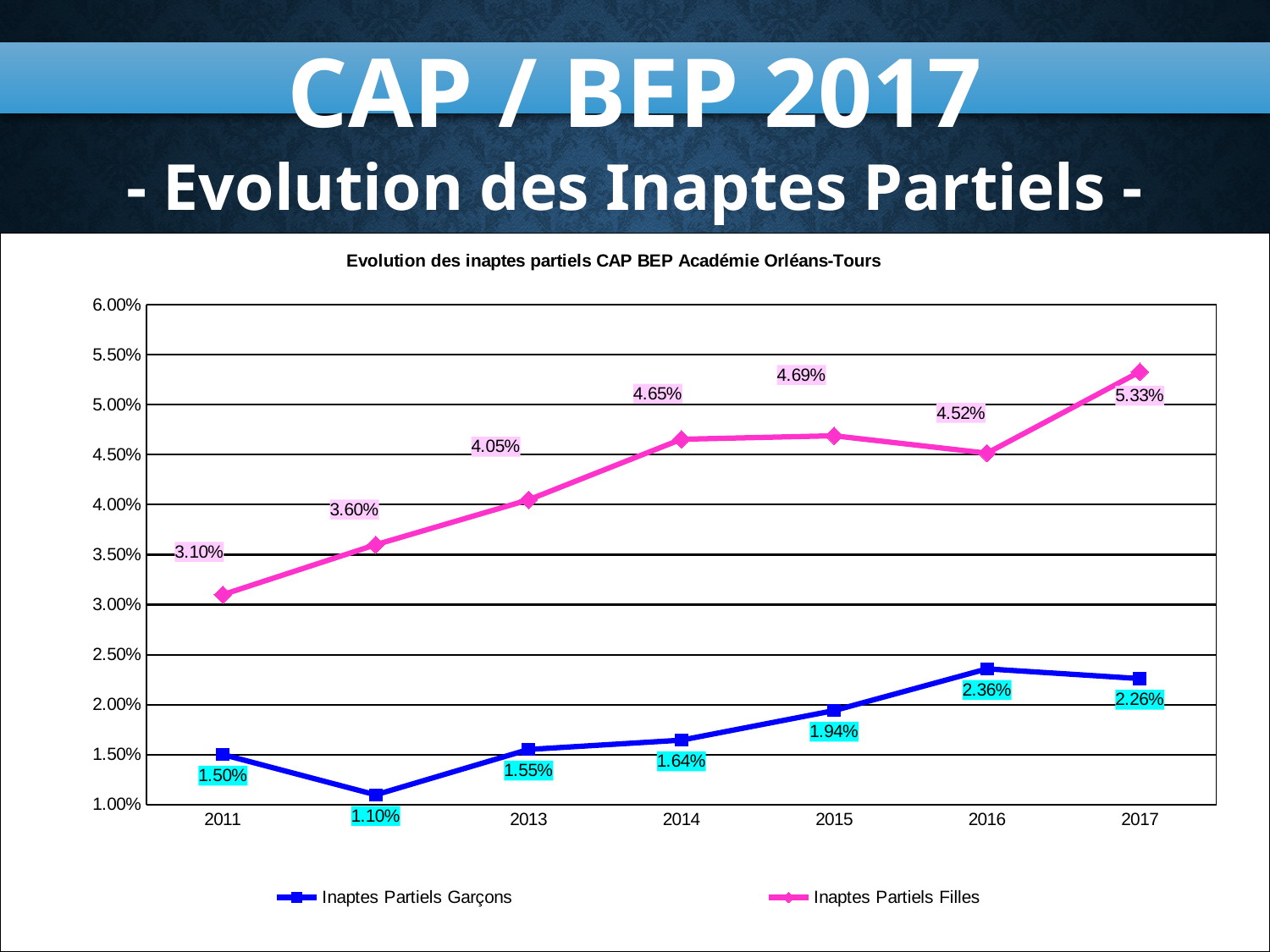
What is the value for Inaptes Partiels Filles in 2013? 4.05% What is the value for Inaptes Partiels Garçons in 2015? 1.94% What is the title of the chart? Evolution des inaptes partiels CAP BEP Académie Orléans-Tours What kind of chart is shown on the slide? Line chart Does the Inaptes Partiels Filles series generally rise or fall from 2011 to 2017? Rise Which is larger: the Inaptes Partiels Garçons value in 2016 or in 2017? 2016 How many data points does each series have? 7 What is the value for Inaptes Partiels Filles in 2017? 5.33% In which year is the value for Inaptes Partiels Filles lowest? 2011 How many series does the legend list? 2 In which year is the value for Inaptes Partiels Garçons highest? 2016 What is the difference between the Inaptes Partiels Filles value in 2017 and in 2011? 2.23%